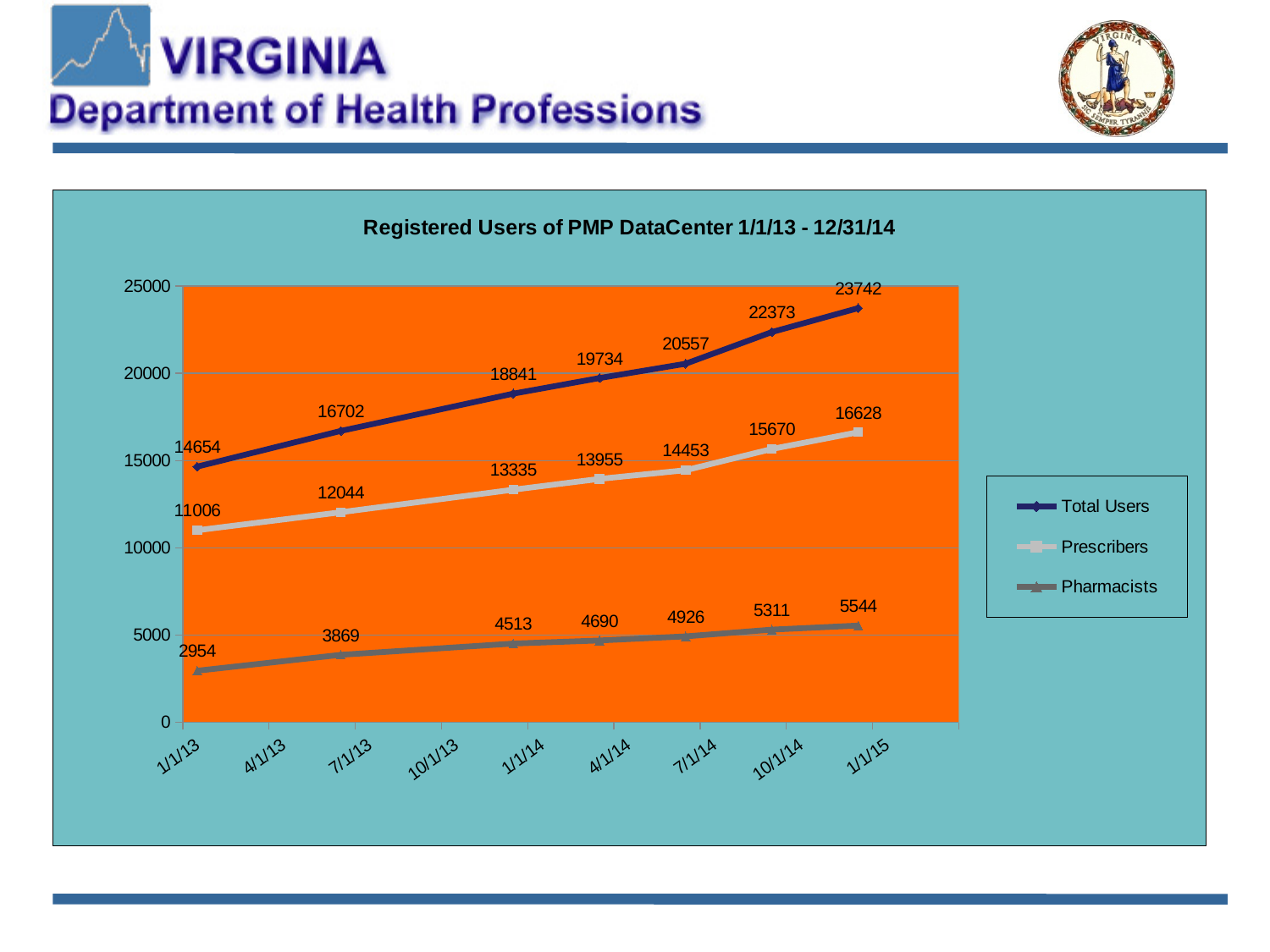
How many data points are plotted for the Total Users series? 7 What is the value for Prescribers at 1/1/13? 11006 What type of chart is shown on the slide? Line chart At which date is the Pharmacists value lowest? 1/1/13 What is the value for Pharmacists at 7/1/14? 4926 Do the Prescribers values rise or fall from 1/1/13 to 1/1/15? Rise How many series does the legend list? 3 What is the difference between the Total Users values at 1/1/15 and 1/1/13? 9088 Which is larger at 10/1/14: the Prescribers value or the Pharmacists value? Prescribers At which date is the Total Users value highest? 1/1/15 What is the value for Total Users at 1/1/15? 23742 What is the title of the chart? Registered Users of PMP DataCenter 1/1/13 - 12/31/14